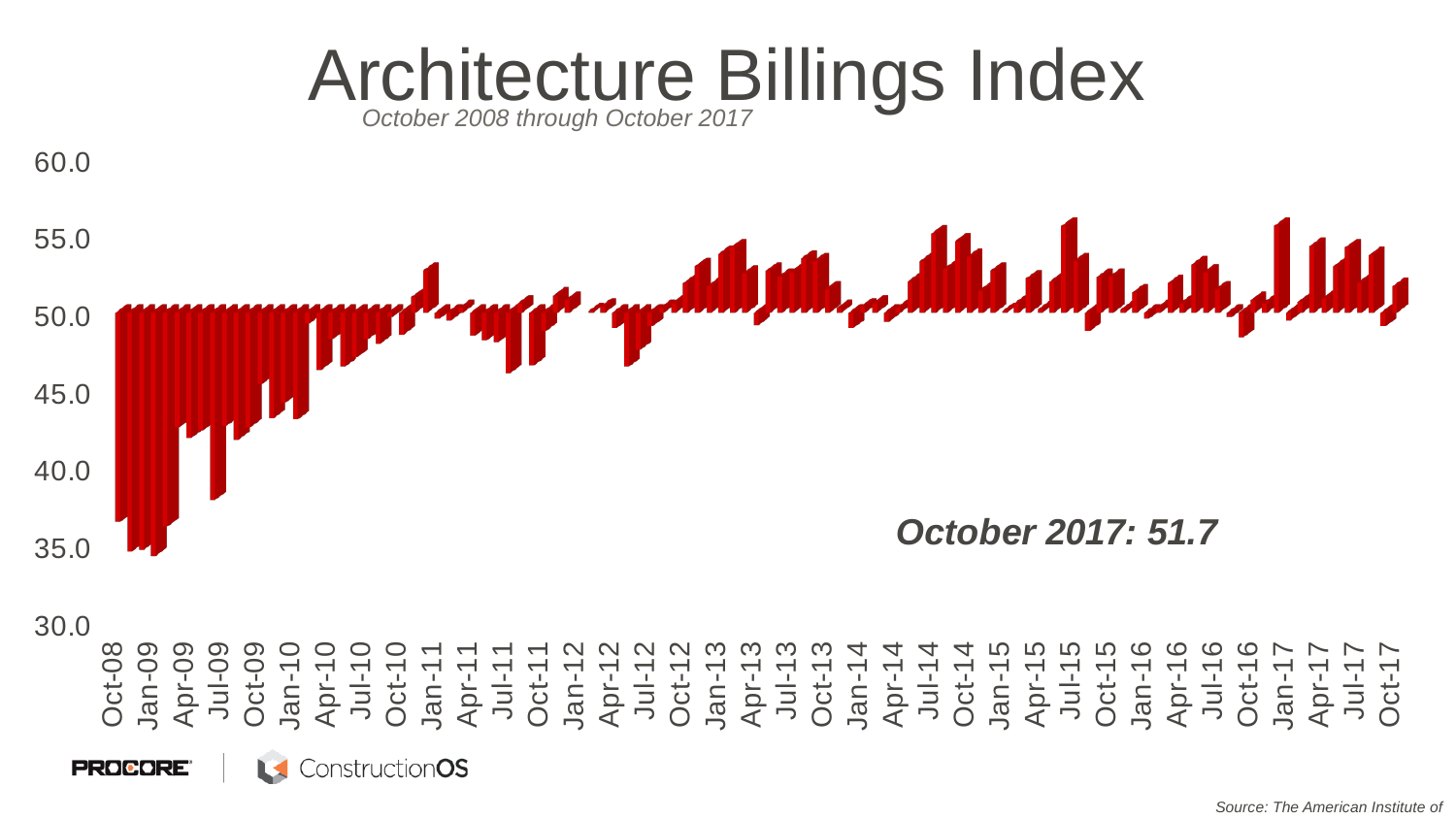
What is the title of the chart? Architecture Billings Index What time period does the chart cover, according to the subtitle? October 2008 through October 2017 Which is larger, the value for Jan-09 or the value for Jan-13? Jan-13 Which is larger, the value for Oct-08 or the value for Oct-17? Oct-17 Is the value for Oct-08 greater or less than 40.0? less What kind of chart is shown on the slide? bar chart Overall, do the values rise or fall from Oct-08 to Oct-17? rise Is the value for Oct-17 greater or less than 50.0? greater Is the value for Apr-09 greater or less than 45.0? less What is the Architecture Billings Index value for October 2017? 51.7